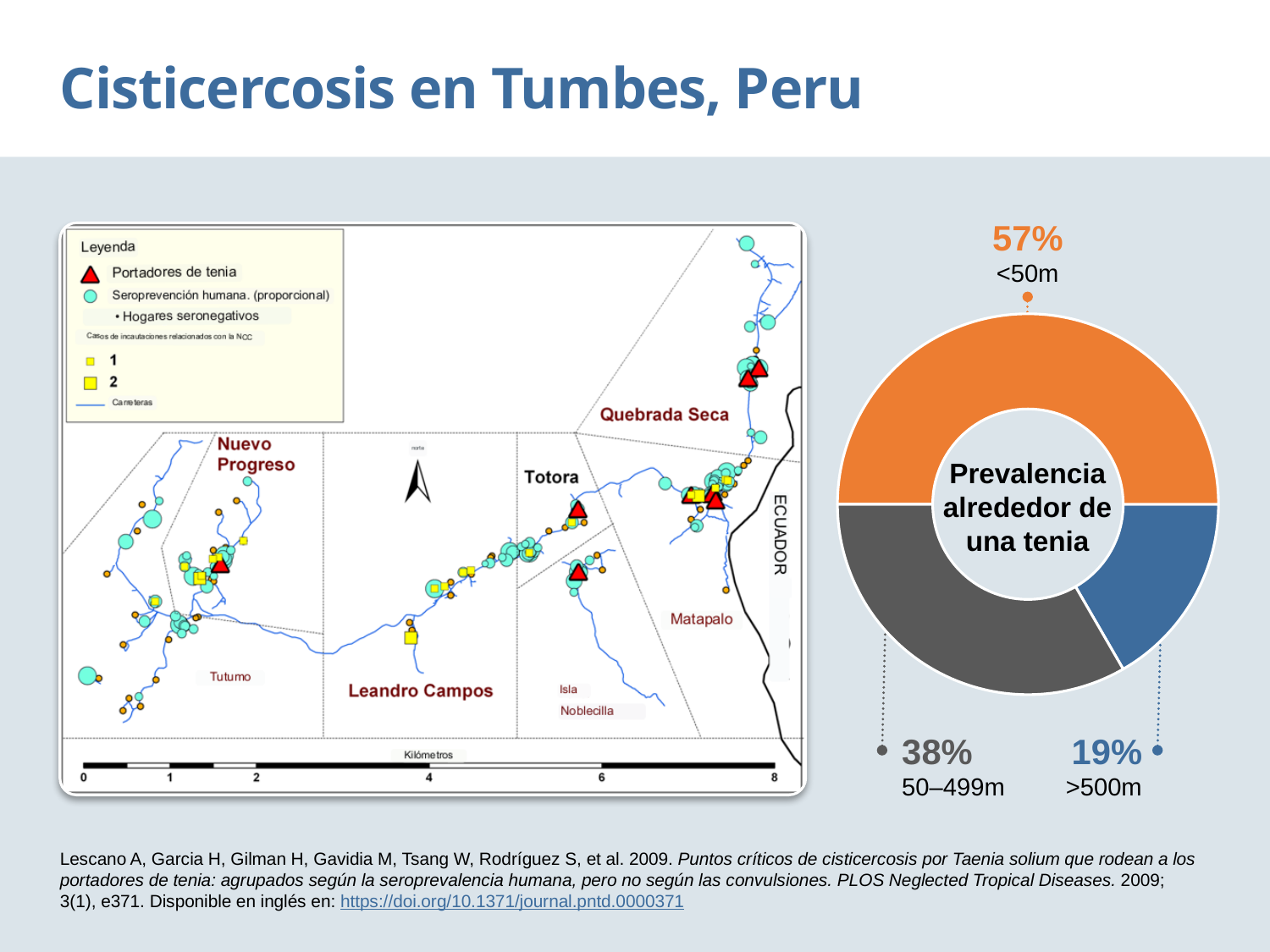
What kind of chart is shown on the right side of the slide? Donut chart On the donut chart, what colour is the <50m slice? Orange What text appears in the centre of the donut chart? Prevalencia alrededor de una tenia On the donut chart, which distance category has the lowest value? >500m On the donut chart, which distance category has the highest value? <50m On the donut chart, what is the value for the 50–499m category? 38% On the donut chart, what is the value for the <50m category? 57% How many categories does the donut chart show? 3 On the donut chart, what is the difference between the values for <50m and >500m? 38% On the donut chart, what is the difference between the values for <50m and 50–499m? 19% On the donut chart, which is larger, the value for 50–499m or the value for >500m? 50–499m On the donut chart, what is the value for the >500m category? 19%